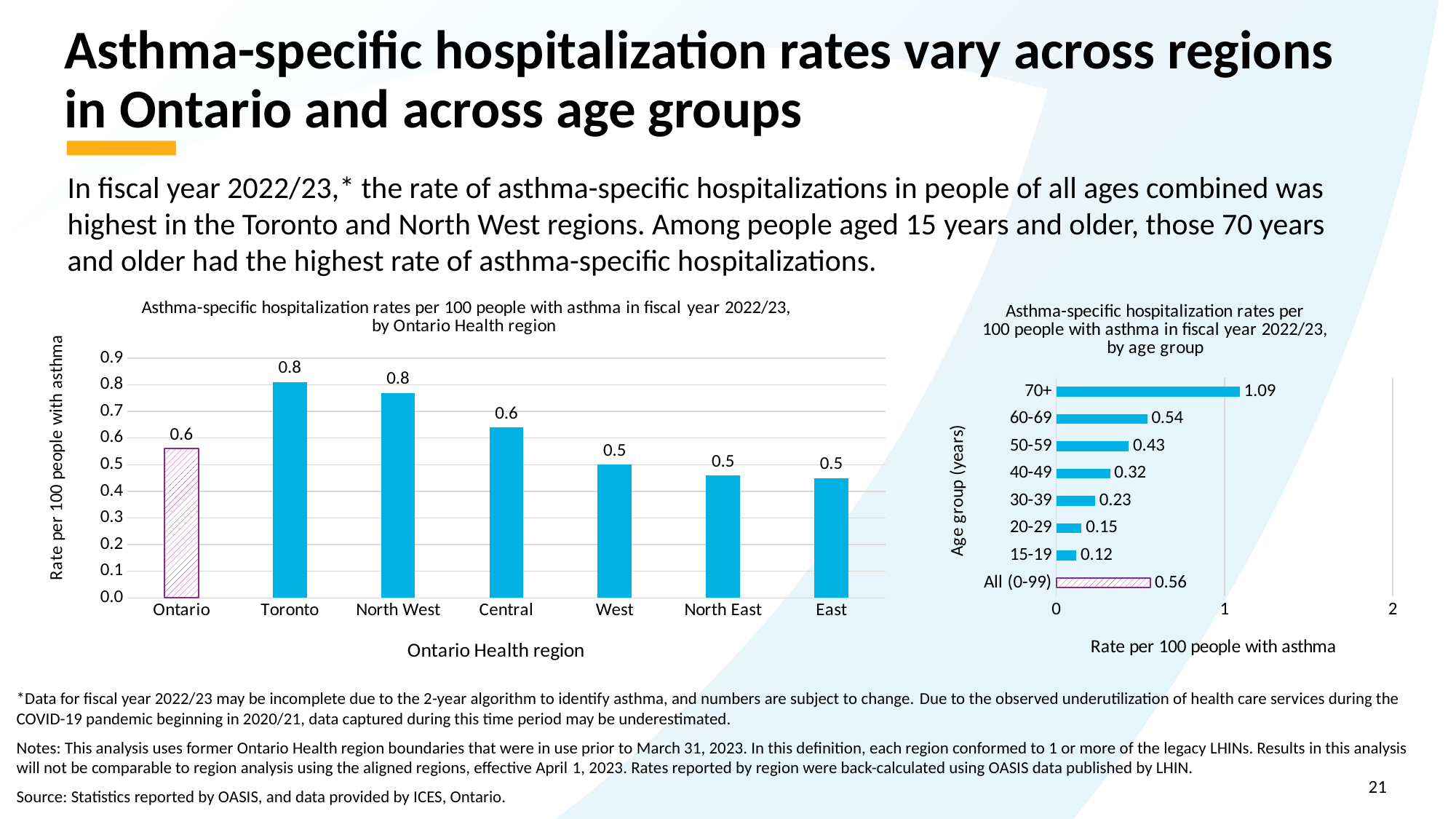
In the chart by Ontario Health region, what is the rate shown for Toronto? 0.8 In the chart by Ontario Health region, what is the asthma-specific hospitalization rate for Central? 0.6 In the chart by age group, what is the difference between the rates for 70+ and 60-69? 0.55 In the chart by age group, how many age group categories are shown? 8 In the chart by Ontario Health region, how many regions (including Ontario) are plotted? 7 In the chart by age group, what is the rate for the 40-49 age group? 0.32 In the chart by Ontario Health region, which is larger, the rate for Toronto or the rate for West? Toronto In the chart by Ontario Health region, is the rate for Toronto greater or less than 0.7? greater What type of chart is the chart by age group? Bar chart In the chart by age group, which age group has the lowest hospitalization rate? 15-19 In the chart by age group, which age group has the highest hospitalization rate? 70+